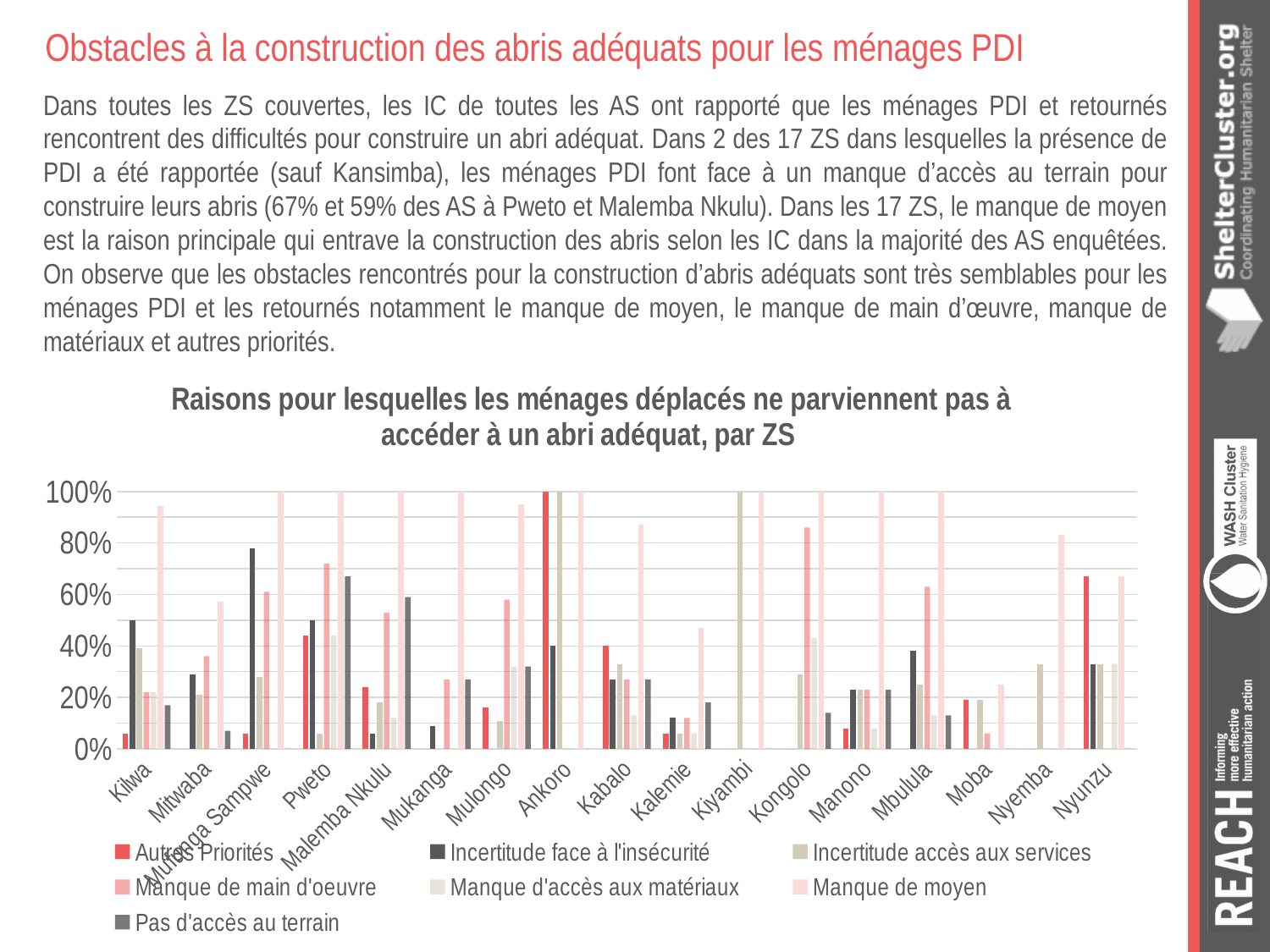
What is the title of the chart? Raisons pour lesquelles les ménages déplacés ne parviennent pas à accéder à un abri adéquat, par ZS Which ZS has the highest value for 'Autres Priorités'? Ankoro What is the value of 'Manque de moyen' for Pweto? 100% What is the value of 'Incertitude accès aux services' for Kiyambi? 100% Is the value of 'Pas d'accès au terrain' for Pweto greater or less than 60%? greater What kind of chart is shown on the slide? bar chart What is the value of 'Autres Priorités' for Ankoro? 100% Which ZS has the highest value for 'Incertitude face à l'insécurité'? Mufunga Sampwe Is the value of 'Autres Priorités' for Kilwa greater or less than 20%? less How many series does the chart legend list? 7 Which is larger: 'Pas d'accès au terrain' for Pweto or 'Pas d'accès au terrain' for Kilwa? Pweto How many ZS (categories) are shown on the x axis of the chart? 17